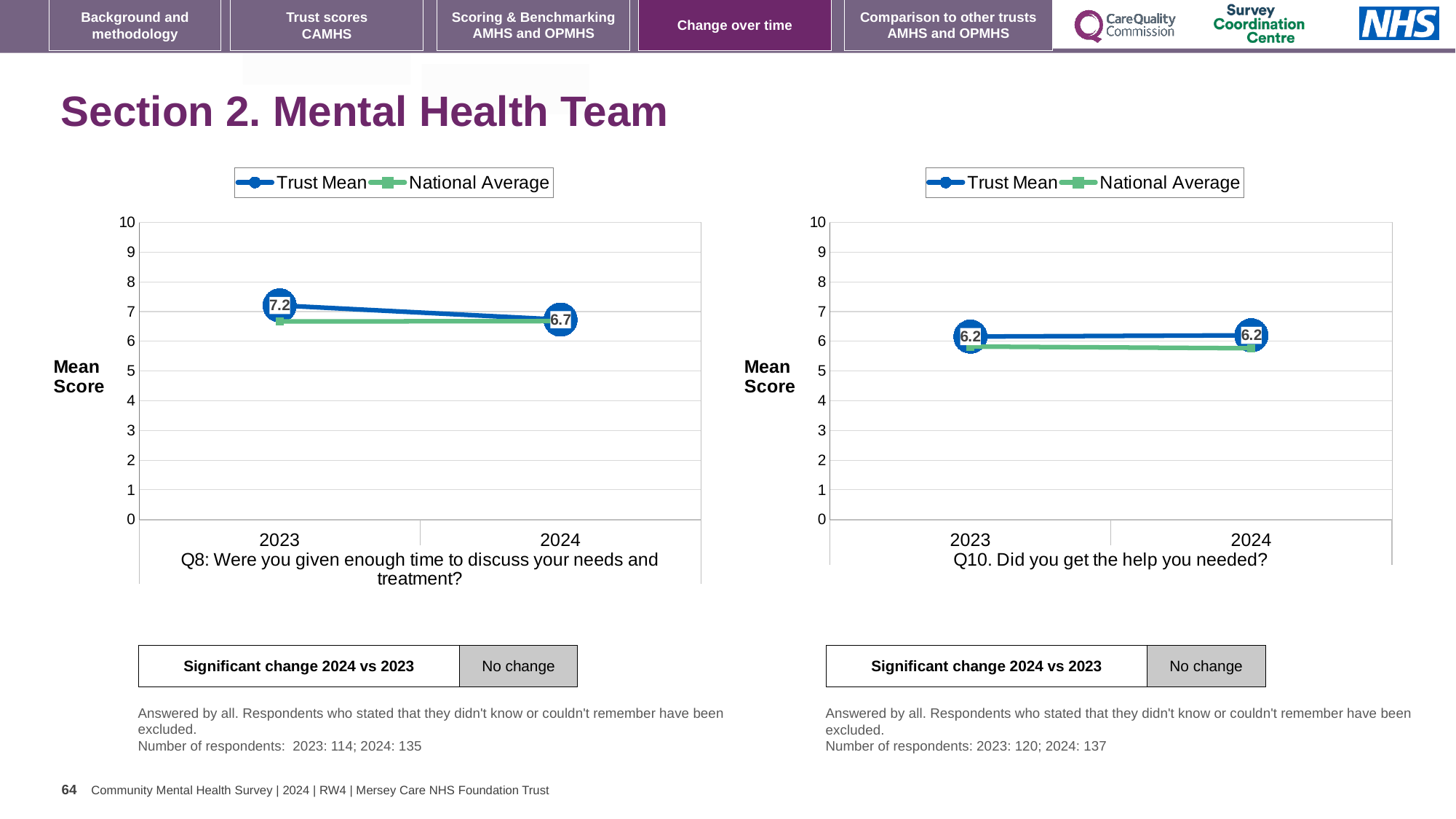
In the Q8 chart on the left, is the National Average for 2023 greater or less than 7? less In the Q10 chart on the right, does the Trust Mean rise, fall or stay the same from 2023 to 2024? stays the same What type of chart is used for Q8 on the left? line chart In the Q8 chart on the left, what is the Trust Mean score for 2024? 6.7 In the Q10 chart on the right, which series is shown in green? National Average In the Q8 chart on the left, by how much did the Trust Mean fall from 2023 to 2024? 0.5 How many series does the legend of the Q10 chart on the right list? 2 In the Q8 chart on the left, which is larger in 2023, the Trust Mean or the National Average? Trust Mean In the Q8 chart on the left, what is the Trust Mean score for 2023? 7.2 How many years are plotted on the x axis of the Q8 chart on the left? 2 In the Q8 chart on the left, does the Trust Mean rise or fall from 2023 to 2024? fall In the Q10 chart on the right, what is the Trust Mean score for 2024? 6.2